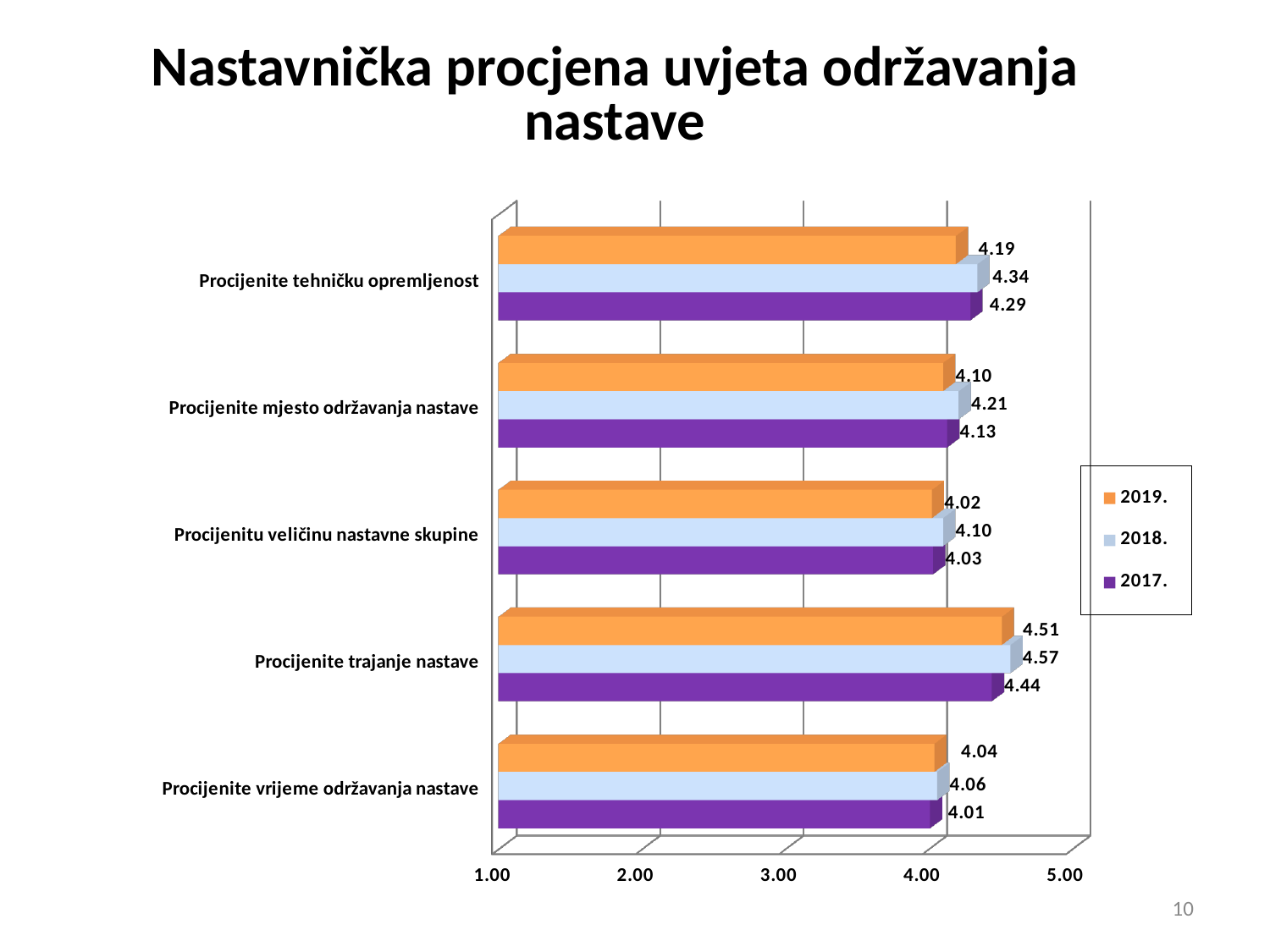
Which category has the highest 2019. value? Procijenite trajanje nastave What is the 2017. value for "Procijenite vrijeme održavanja nastave"? 4.01 What is the 2019. value for "Procijenite tehničku opremljenost"? 4.19 Which category has the lowest 2017. value? Procijenite vrijeme održavanja nastave Which is larger for "Procijenite mjesto održavanja nastave": the 2018. value or the 2017. value? 2018. What is the 2018. value for "Procijenite trajanje nastave"? 4.57 How many categories are shown on the chart? 5 Is the 2019. value for "Procijenite trajanje nastave" greater or less than 4.00? greater How many series does the legend list? 3 What is the difference between the 2018. and 2019. values for "Procijenite tehničku opremljenost"? 0.15 Which colour represents the 2017. series? purple What kind of chart is shown on the slide? bar chart